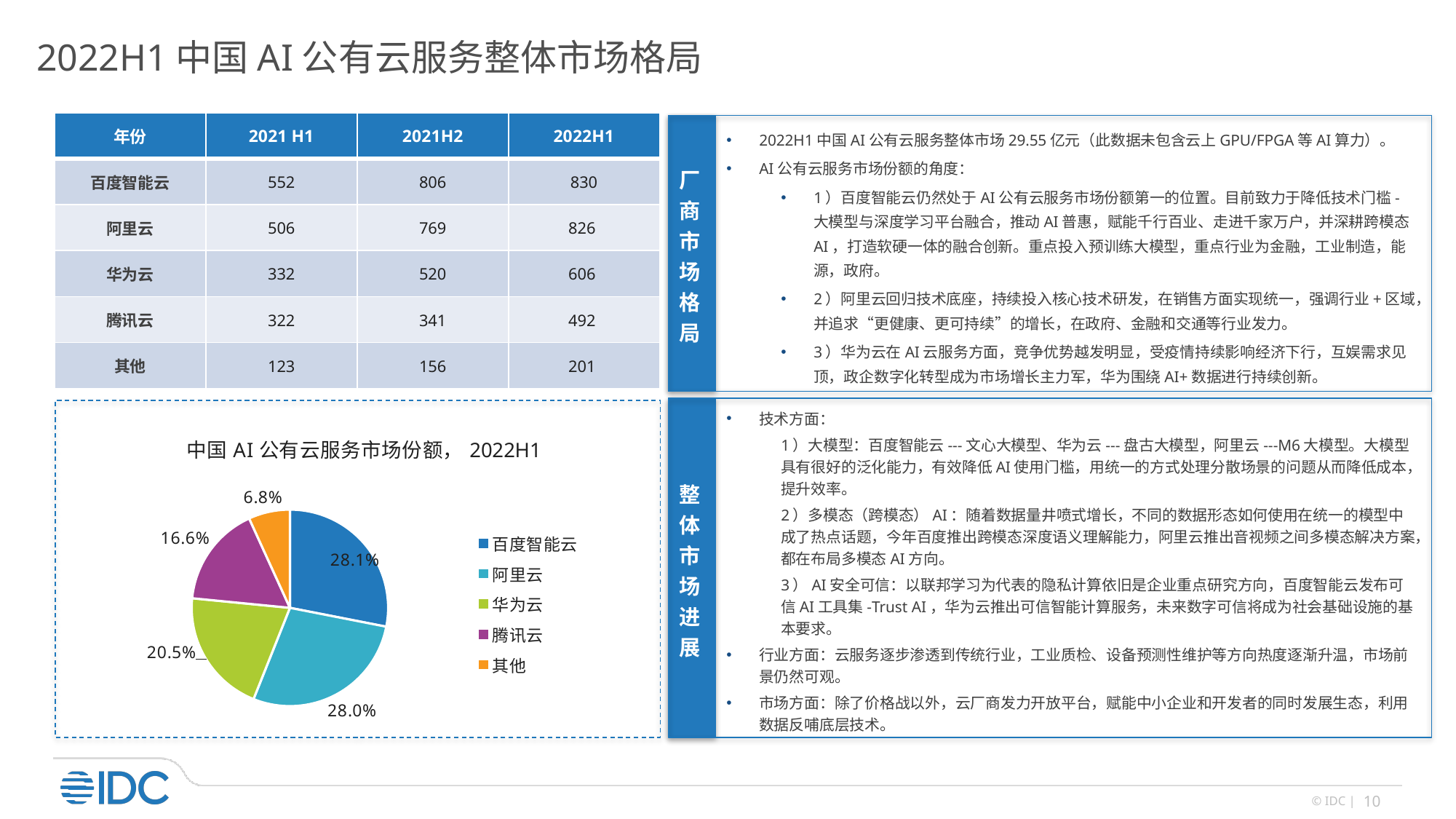
What share of the pie chart does 华为云 hold? 20.5% What share of the pie chart does 阿里云 hold? 28.0% What share of the pie chart does 百度智能云 hold? 28.1% What colour is the 其他 slice in the pie chart? orange What share of the pie chart does 其他 hold? 6.8% Which has the larger share in the pie chart, 华为云 or 腾讯云? 华为云 What share of the pie chart does 腾讯云 hold? 16.6% How many slices does the pie chart have? 5 What is the title of the pie chart? 中国 AI 公有云服务市场份额， 2022H1 What is the difference in share between 华为云 and 腾讯云 in the pie chart? 3.9% What kind of chart is shown on the slide? pie chart Which slice of the pie chart is the smallest? 其他